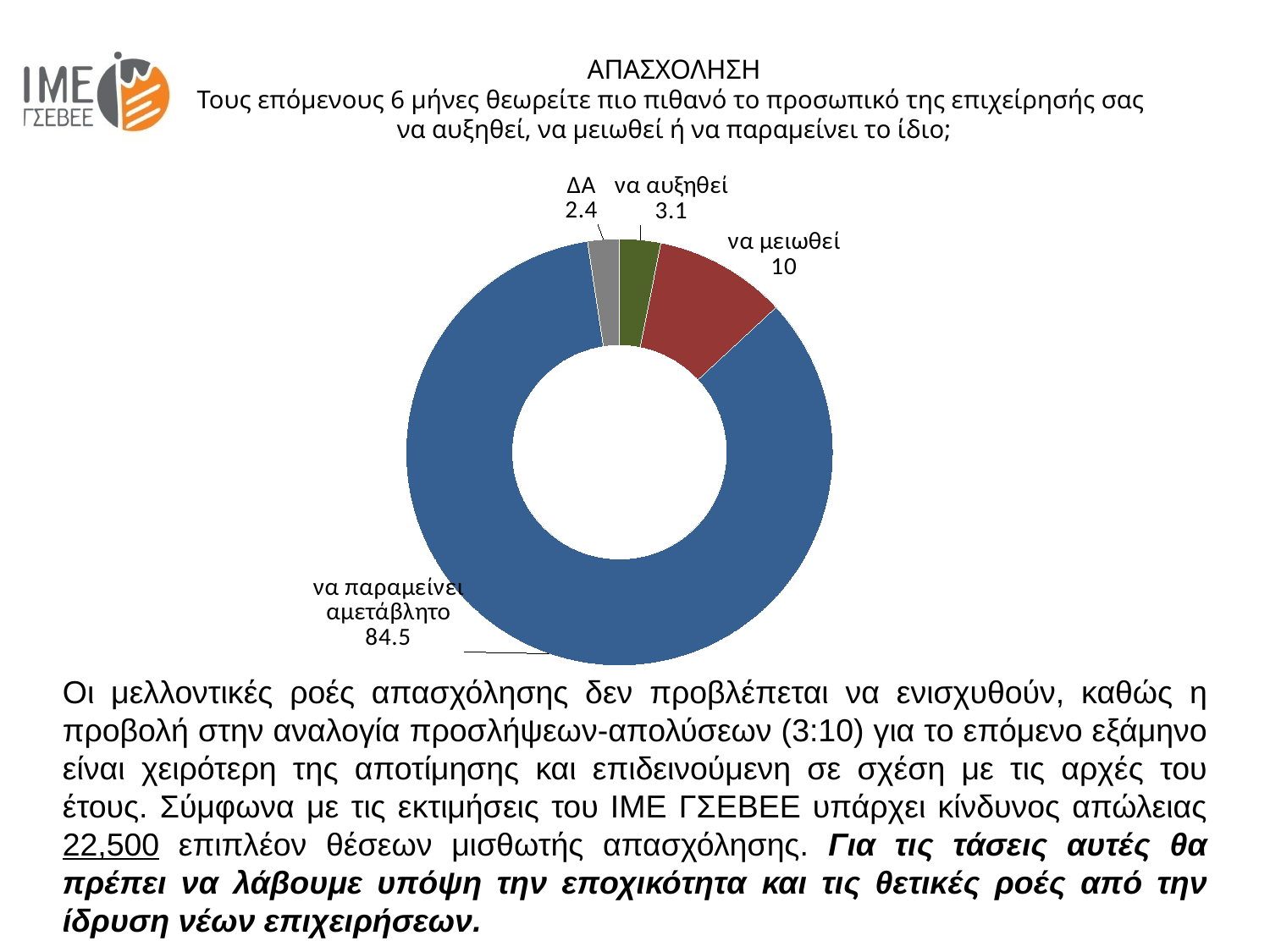
How many categories does the chart show? 4 Which is larger, the value for "να μειωθεί" or the value for "να αυξηθεί"? να μειωθεί What value is shown for "να παραμείνει αμετάβλητο"? 84.5 Which category has the largest slice? να παραμείνει αμετάβλητο What value is shown for "να αυξηθεί"? 3.1 What is the difference between the values for "να παραμείνει αμετάβλητο" and "να μειωθεί"? 74.5 What is the title of the chart? ΑΠΑΣΧΟΛΗΣΗ What kind of chart is shown on the slide? doughnut chart What is the difference between the values for "να μειωθεί" and "να αυξηθεί"? 6.9 What value is shown for "ΔΑ"? 2.4 What value is shown for "να μειωθεί"? 10 Which category has the smallest slice? ΔΑ